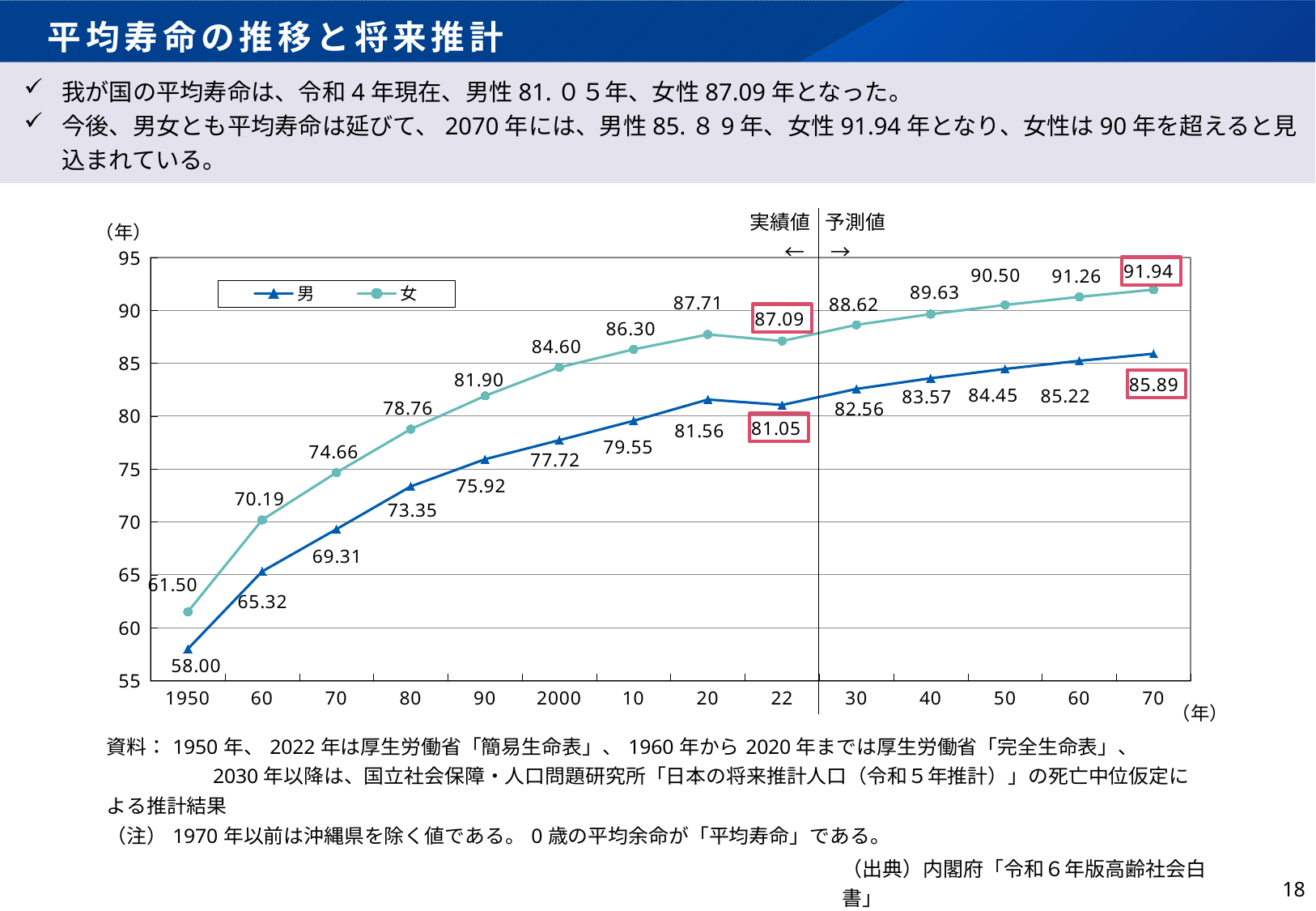
Which year has the lowest value for 男 (male)? 1950 What is the difference between the 女 (female) and 男 (male) values in 2022? 6.04 What is the value for 女 (female) in 2022? 87.09 How many series does the legend list? 2 What is the value for 男 (male) in 1950? 58.00 What is the value for 女 (female) in 2000? 84.60 Which is larger in 2020: the value for 男 (male) or 女 (female)? 女 (female) Which year has the highest value for 女 (female)? 2070 What kind of chart is shown on the slide? Line chart How many years are plotted on the x axis? 14 What is the projected value for 男 (male) in 2070? 85.89 Do the values for 男 (male) generally rise or fall from 1950 to 2070? Rise